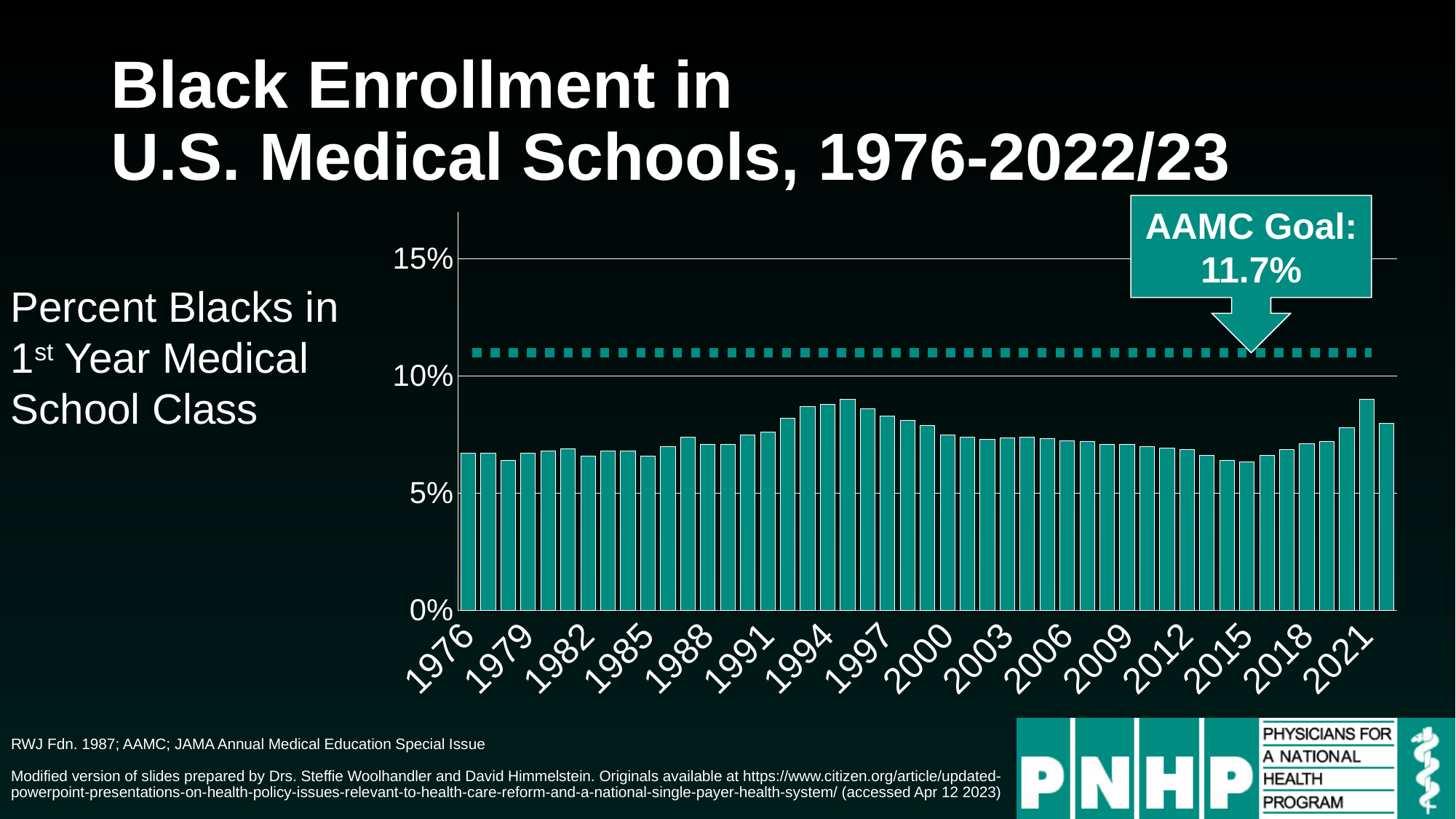
Is the value for 1976 greater or less than 5%? greater What AAMC goal percentage is marked by the dotted line on the chart? 11.7% Do the values generally rise or fall from 1985 to 1994? rise Do the values generally rise or fall from 1994 to 2015? fall What is the title of the slide's chart? Black Enrollment in U.S. Medical Schools, 1976-2022/23 Which year has the larger value, 1976 or 1994? 1994 Do any of the bars reach the AAMC goal line of 11.7%? No Which year has the larger value, 1994 or 2015? 1994 Is the value for 2015 greater or less than 10%? less What kind of chart is shown on the slide? bar chart